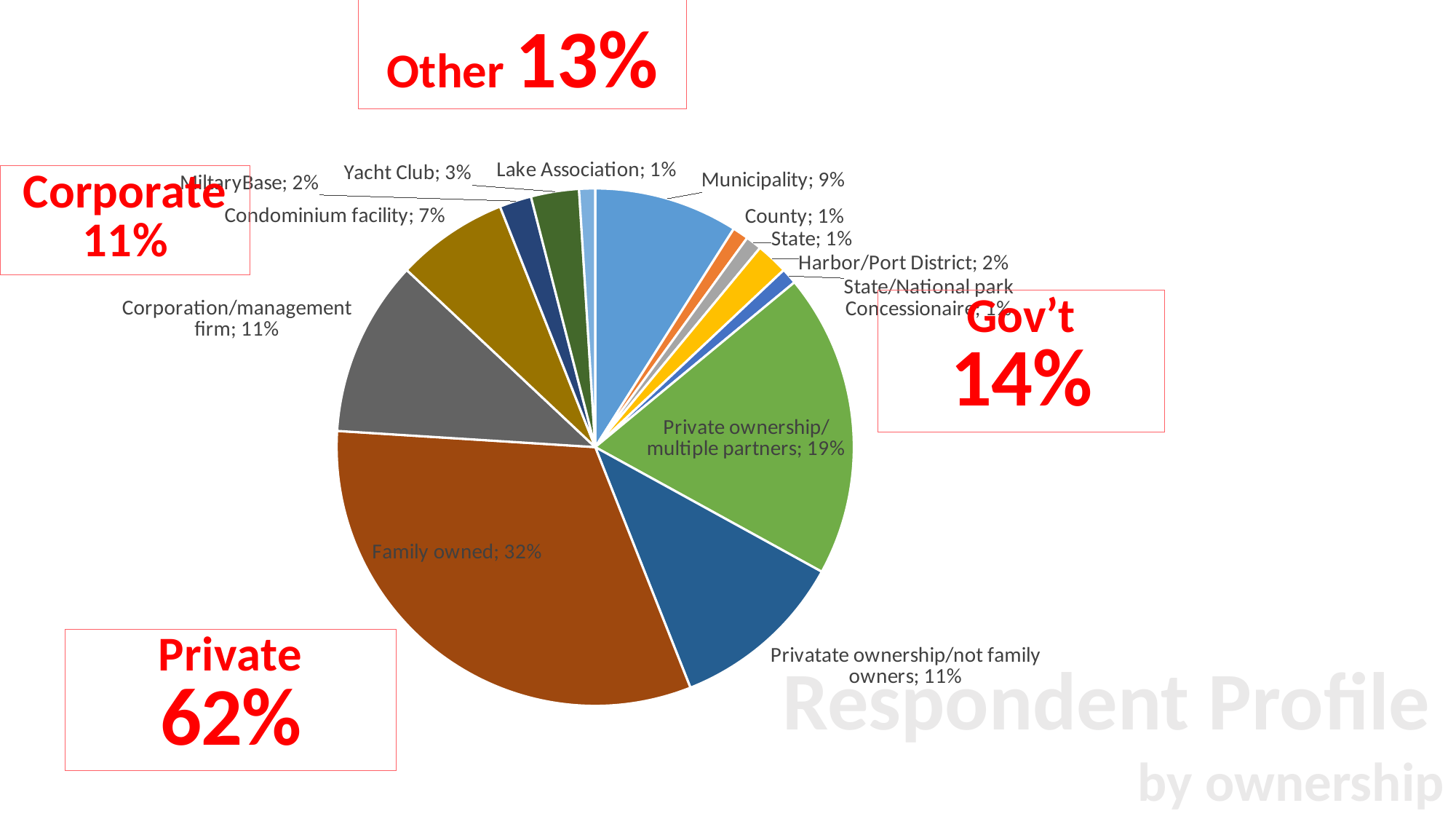
What percentage does the red summary box give for Gov't ownership? 14% Which is larger, the Yacht Club slice or the Harbor/Port District slice? Yacht Club What is the difference between the Family owned share and the Private ownership/multiple partners share? 13% What percentage is shown for Municipality? 9% What is the title shown in the bottom-right corner of the slide? Respondent Profile by ownership What percentage of respondents are Family owned? 32% Which category has the largest slice of the pie? Family owned What kind of chart is shown on the slide? Pie chart How many slices does the pie chart have? 13 What percentage does the red summary box give for Private ownership? 62% What percentage is shown for Private ownership/multiple partners? 19% What percentage is shown for Condominium facility? 7%